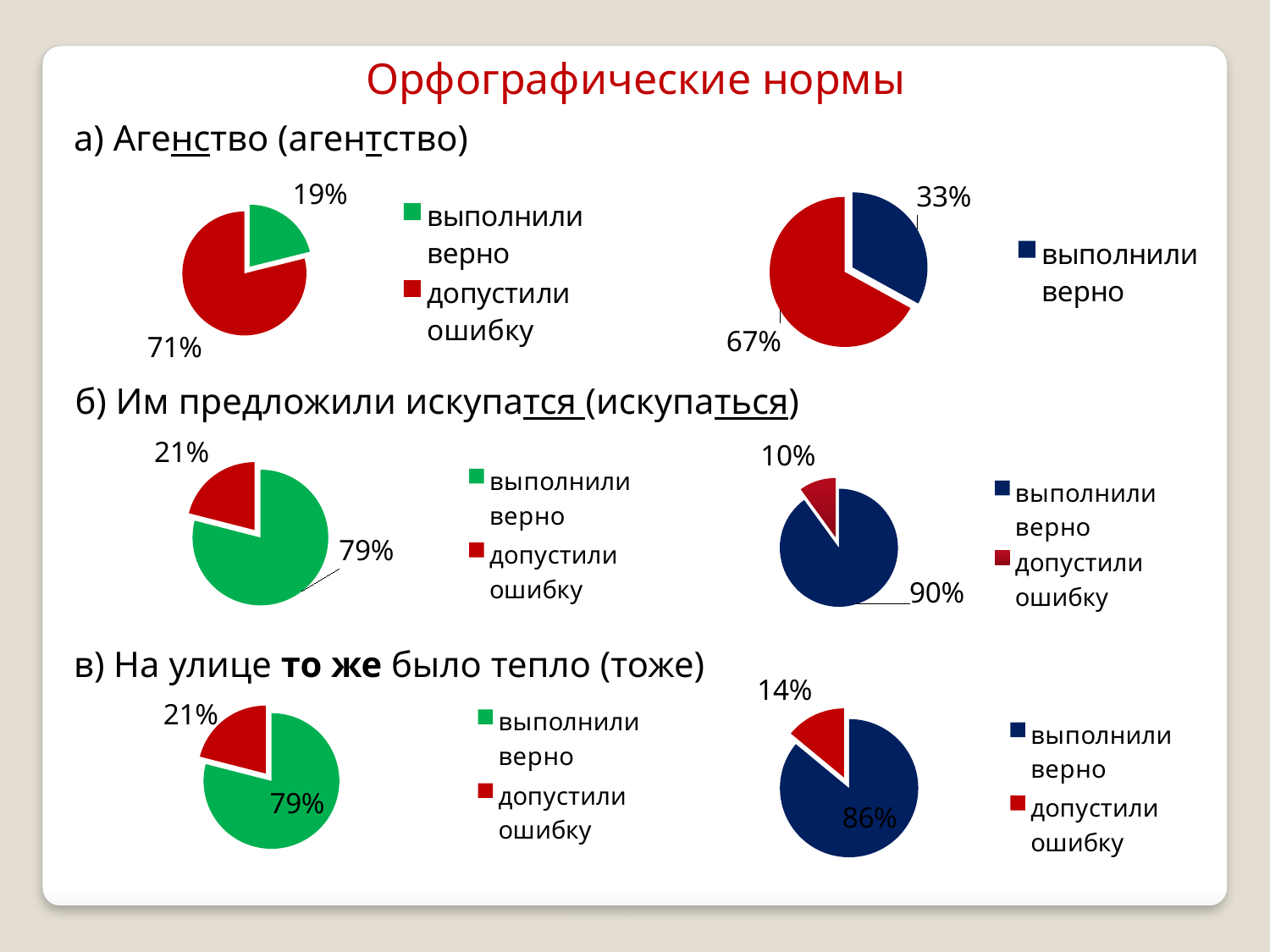
What type of chart is used in section б) on the left? pie chart In section а), what value is shown for 'допустили ошибку' on the left pie chart? 71% How many entries does the legend list for the right pie chart in section а)? 1 In section в), what value is shown for 'допустили ошибку' on the left pie chart? 21% In section б), what value is shown for 'выполнили верно' on the left pie chart? 79% In section б), which slice is larger on the right pie chart: 'выполнили верно' or 'допустили ошибку'? выполнили верно In section а), which slice is the largest on the left pie chart? допустили ошибку In section в), what value is shown for 'выполнили верно' on the right pie chart? 86% In section а), what value is shown for 'выполнили верно' on the right pie chart? 33% In section а), what value is shown for 'выполнили верно' on the left pie chart? 19% In section б), what value is shown for 'допустили ошибку' on the right pie chart? 10% In section в), what is the difference between 'выполнили верно' and 'допустили ошибку' on the right pie chart? 72%